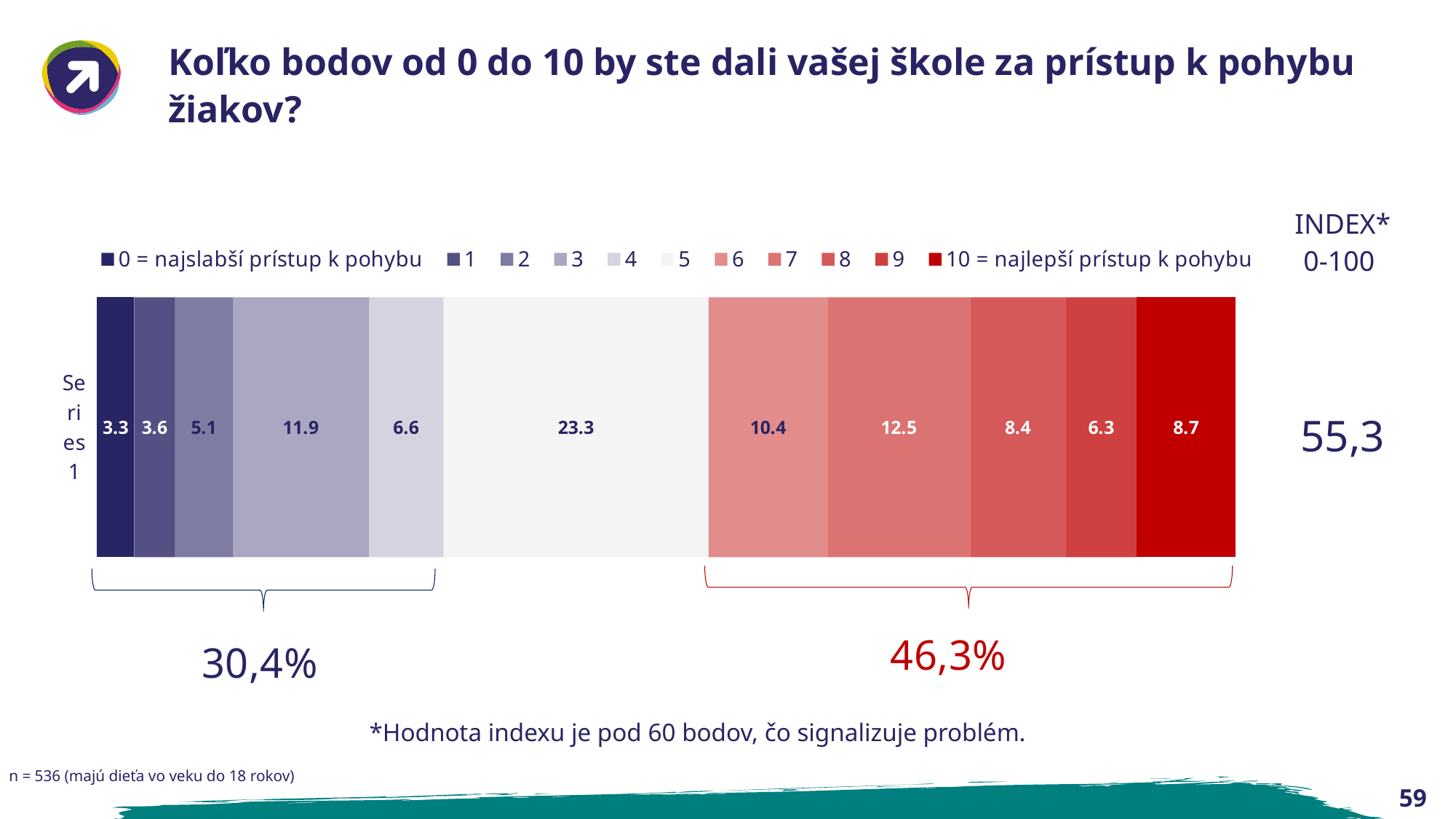
What is the value of the segment for score 10 (najlepší prístup k pohybu)? 8.7 Which score has the smallest segment in the bar? 0 What is the INDEX value (0-100) shown to the right of the chart? 55,3 Which score has the largest segment in the bar? 5 What kind of chart is shown on the slide? stacked bar chart Which is larger, the segment for score 3 or the segment for score 4? score 3 What is the value of the segment for score 7? 12.5 What percentage is shown under the red bracket covering scores 6 to 10? 46,3% What is the value of the segment for score 5? 23.3 What is the difference between the segment for score 7 and the segment for score 6? 2.1 How many series does the legend list? 11 What is the value of the segment for score 0 (najslabší prístup k pohybu)? 3.3